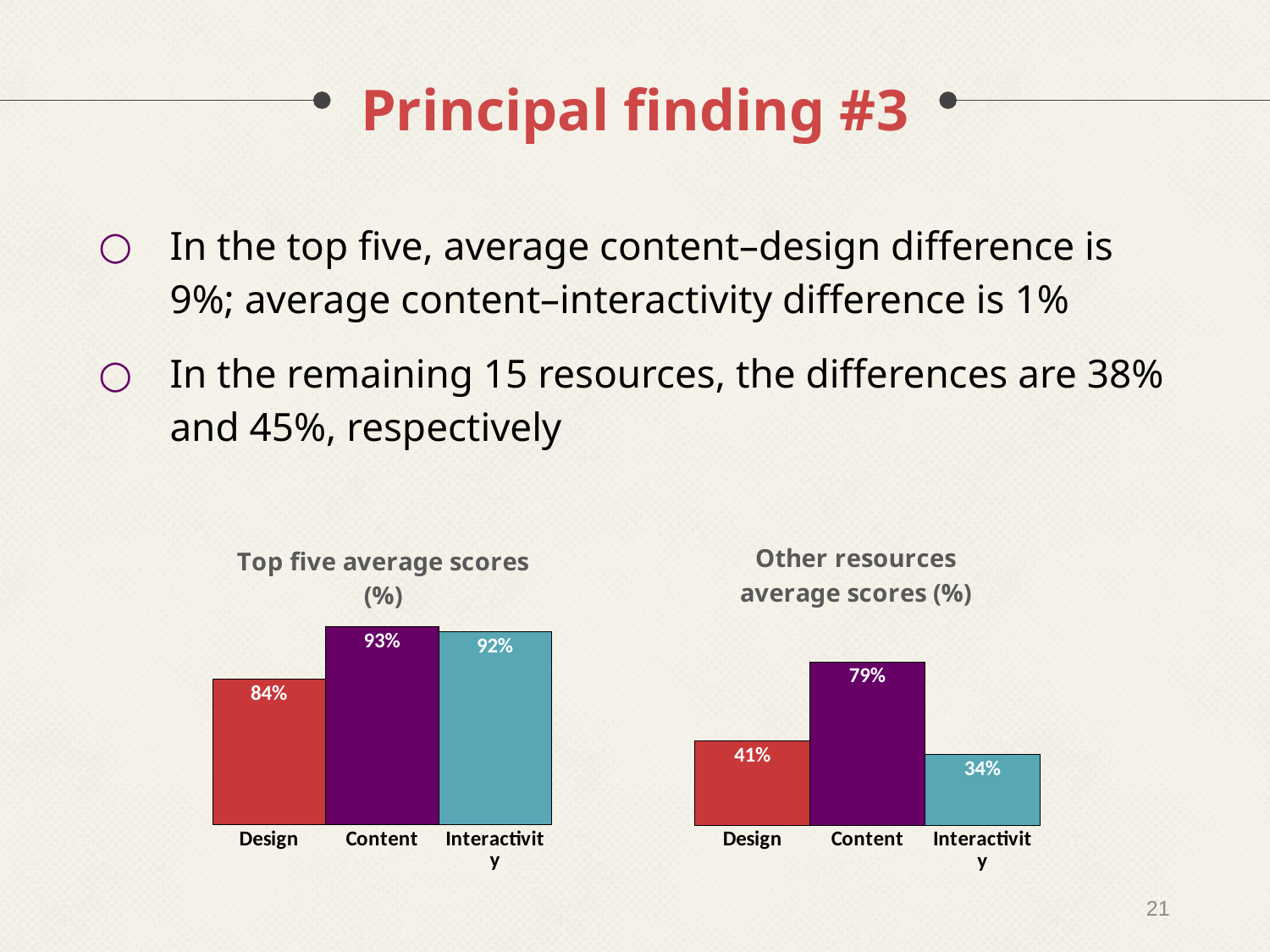
In the 'Top five average scores (%)' chart, what is the difference between Content and Interactivity? 1% How many categories are shown in the 'Top five average scores (%)' chart? 3 In the 'Top five average scores (%)' chart, which category has the lowest value? Design In the 'Top five average scores (%)' chart, what is the value for Design? 84% In the 'Other resources average scores (%)' chart, which category has the highest value? Content In the 'Other resources average scores (%)' chart, what is the difference between Content and Design? 38% In the 'Other resources average scores (%)' chart, which category has the lowest value? Interactivity In the 'Other resources average scores (%)' chart, what is the value for Design? 41% In the 'Top five average scores (%)' chart, what is the value for Content? 93% In the 'Other resources average scores (%)' chart, what is the value for Interactivity? 34% What type of chart is the 'Other resources average scores (%)' chart? Bar chart In the 'Other resources average scores (%)' chart, which is larger, Design or Interactivity? Design